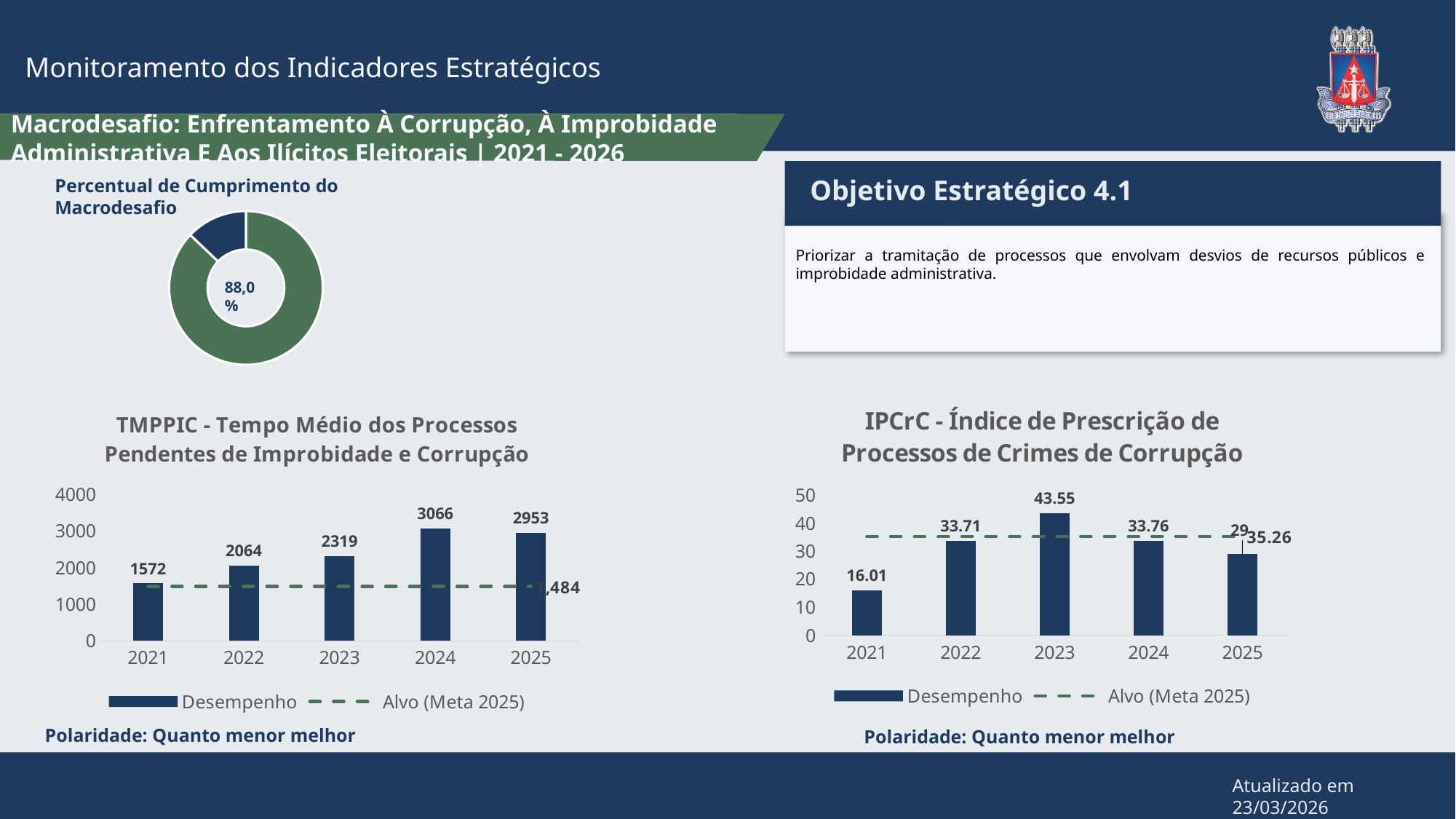
In the TMPPIC chart, what is the difference between the 2024 and 2025 values? 113 In the TMPPIC chart, what is the Desempenho value for 2024? 3066 In the IPCrC chart, which year has the highest Desempenho value? 2023 In the TMPPIC chart, which year has the highest Desempenho value? 2024 In the IPCrC chart, what is the Desempenho value for 2023? 43.55 In the donut chart 'Percentual de Cumprimento do Macrodesafio', what percentage is shown? 88,0% In the IPCrC chart, what is the difference between the 2023 and 2022 values? 9.84 What kind of chart is the TMPPIC chart? Combination bar and line chart (bars for Desempenho with a dashed target line for Alvo) In the TMPPIC chart, which year has the lowest Desempenho value? 2021 In the IPCrC chart, what is the value of the Alvo (Meta 2025) line? 35.26 In the TMPPIC chart, how many years are plotted on the x axis? 5 In the IPCrC chart, is the value for 2021 greater or less than 20? less